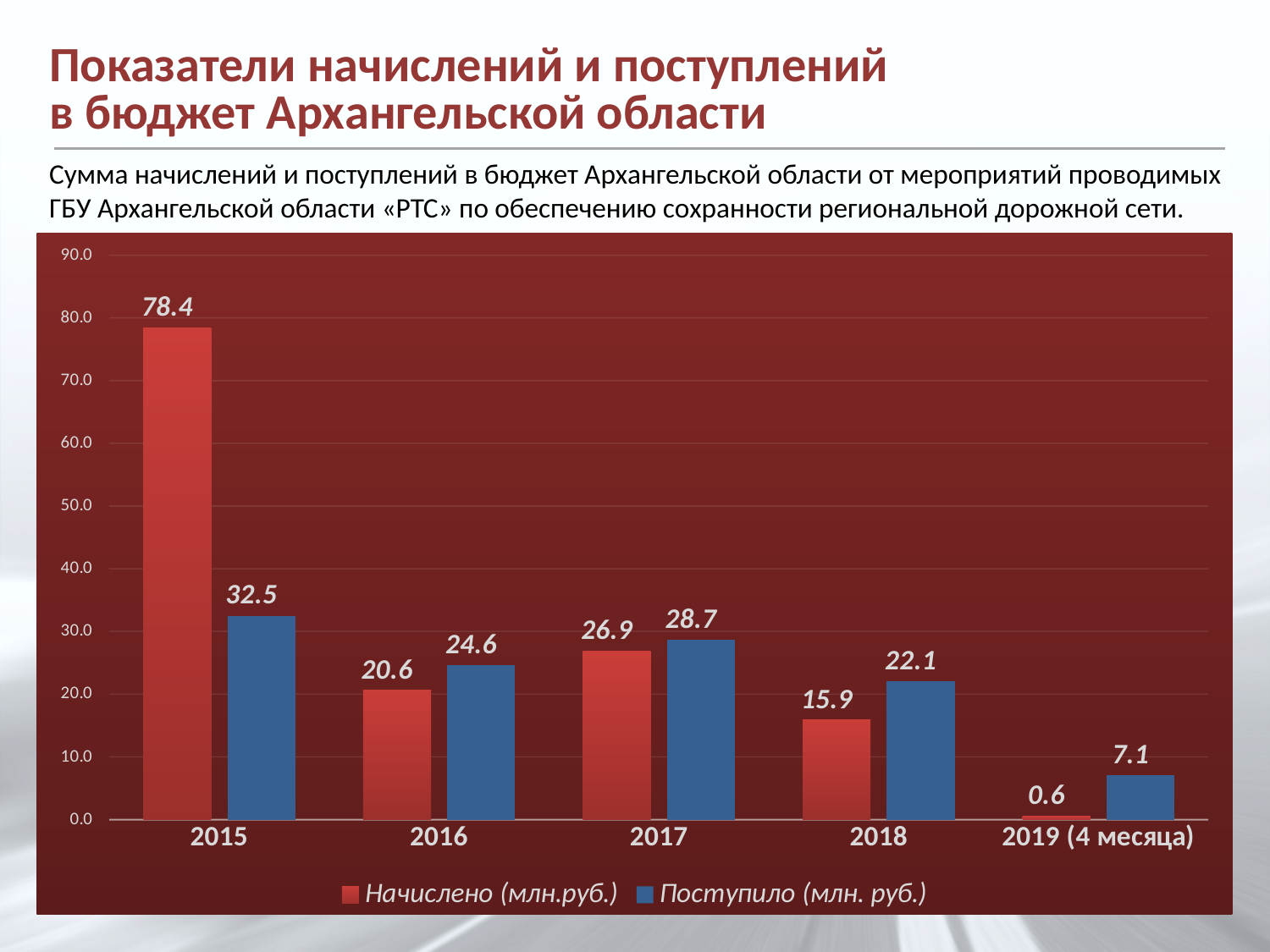
Which is larger for 2017: Начислено (млн.руб.) or Поступило (млн. руб.)? Поступило (млн. руб.) Which year has the highest value of Начислено (млн.руб.)? 2015 What kind of chart is shown on the slide? bar chart Which colour represents the series Поступило (млн. руб.)? blue Is the value of Поступило (млн. руб.) for 2016 greater or less than 20.0? greater How many categories are shown on the x axis? 5 How many series does the legend list? 2 What is the value of Поступило (млн. руб.) for 2018? 22.1 What is the value of Начислено (млн.руб.) for 2015? 78.4 What is the difference between Начислено and Поступило for 2015? 45.9 Which category has the lowest value of Поступило (млн. руб.)? 2019 (4 месяца) What is the value of Начислено (млн.руб.) for 2019 (4 месяца)? 0.6